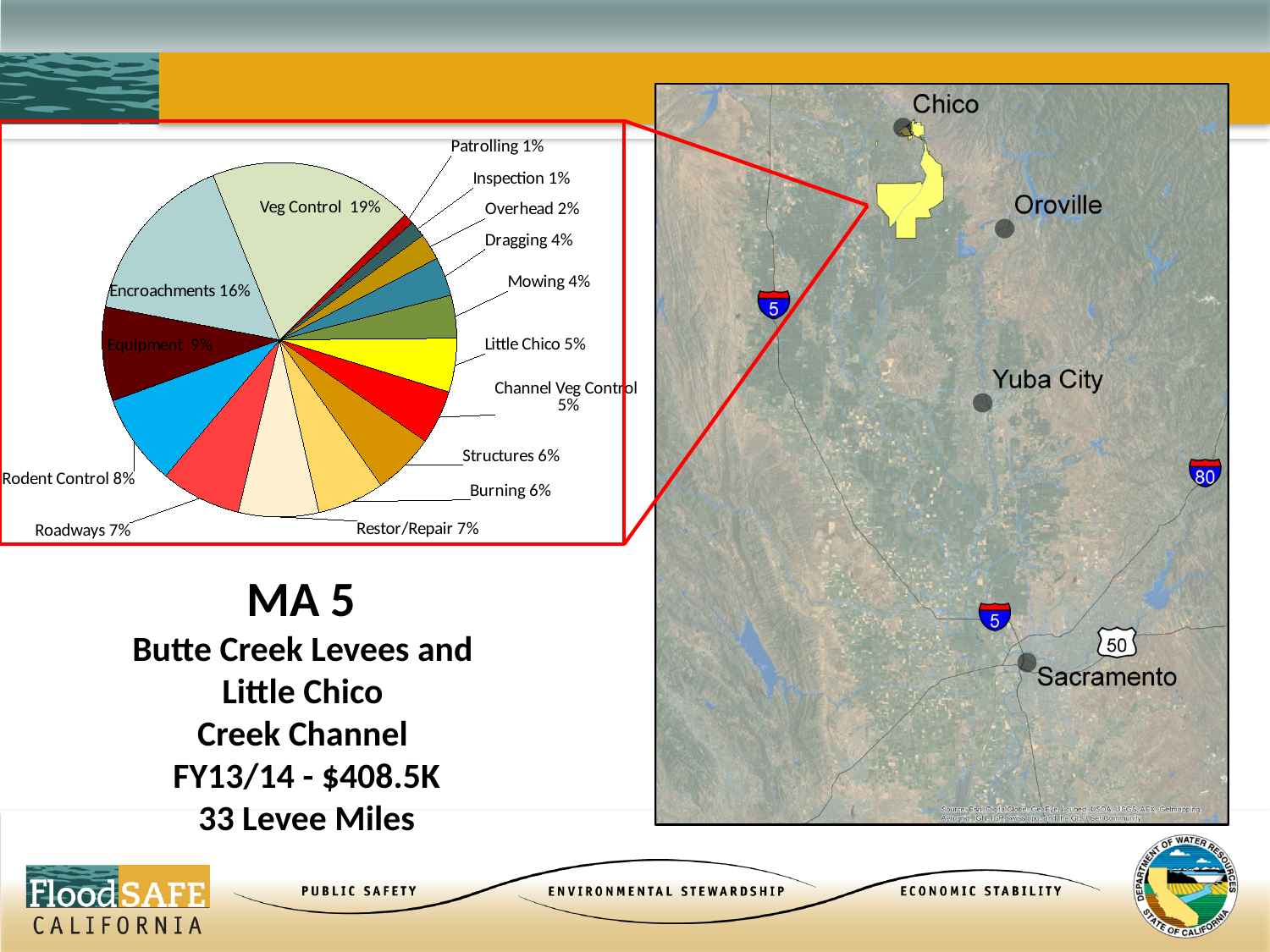
What is the combined share of Structures and Burning in the pie chart? 12% Which is larger in the pie chart, Roadways or Mowing? Roadways What is the difference in percentage points between Veg Control and Encroachments? 3 What percentage is shown for Rodent Control in the pie chart? 8% What percentage is shown for Overhead in the pie chart? 2% What percentage is shown for Restor/Repair in the pie chart? 7% Which is larger in the pie chart, Little Chico or Dragging? Little Chico How many categories are shown in the pie chart? 15 What share of the pie chart does Encroachments represent? 16% What kind of chart is shown on the slide? pie chart Which category has the largest share of the pie chart? Veg Control What percentage is shown for Equipment in the pie chart? 9%